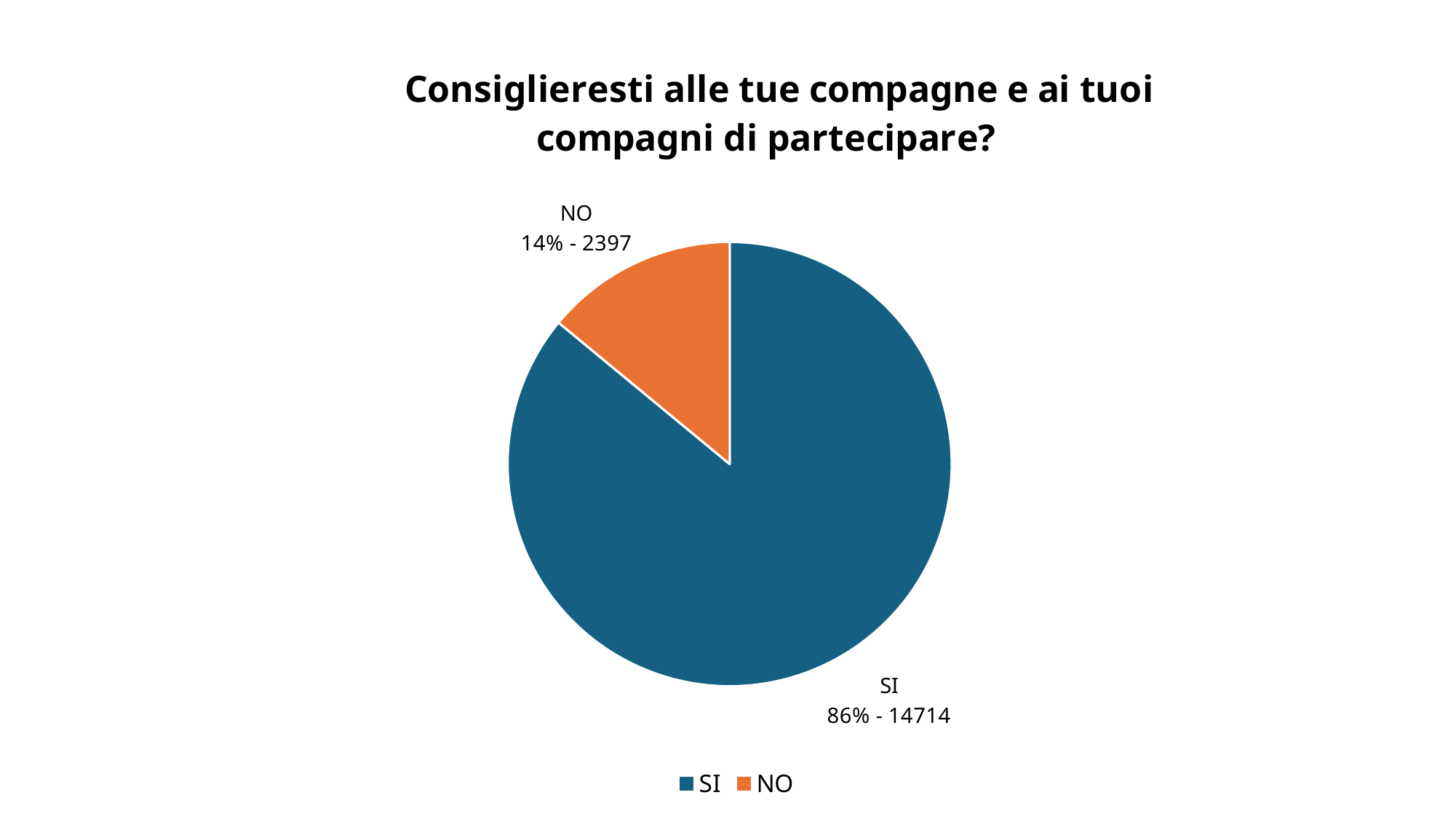
Which slice is the smallest? NO What percentage share does the SI slice have? 86% What is the count shown for SI? 14714 What is the count shown for NO? 2397 What is the title of the chart? Consiglieresti alle tue compagne e ai tuoi compagni di partecipare? Which slice is the largest? SI How many slices does the pie chart have? 2 What is the difference between the counts for SI and NO? 12317 Which colour represents the NO slice? orange What percentage share does the NO slice have? 14% What kind of chart is shown on the slide? pie chart How many entries does the legend list? 2